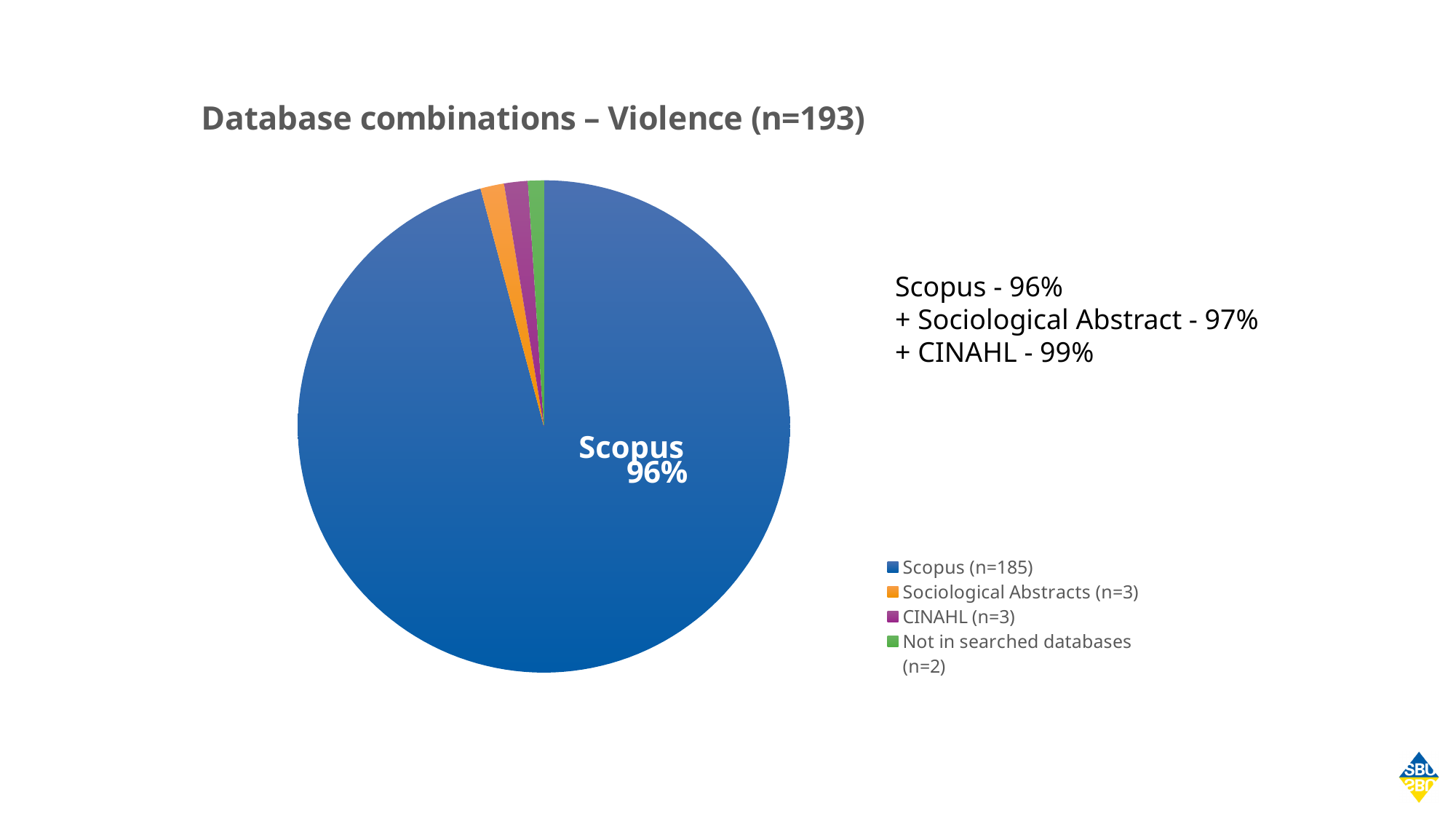
What colour is the Scopus slice? blue What share of the pie does Scopus take? 96% Which category has the smallest slice of the pie? Not in searched databases What is the title of the chart? Database combinations – Violence (n=193) What is the n value shown in the legend for Not in searched databases? 2 Which category has the largest slice of the pie? Scopus Which is larger, the slice for Scopus or the slice for Sociological Abstracts? Scopus What is the n value shown in the legend for Scopus? 185 What is the n value shown in the legend for CINAHL? 3 What type of chart is shown on the slide? pie chart What is the difference between the n values for Scopus and CINAHL shown in the legend? 182 How many categories does the legend list? 4